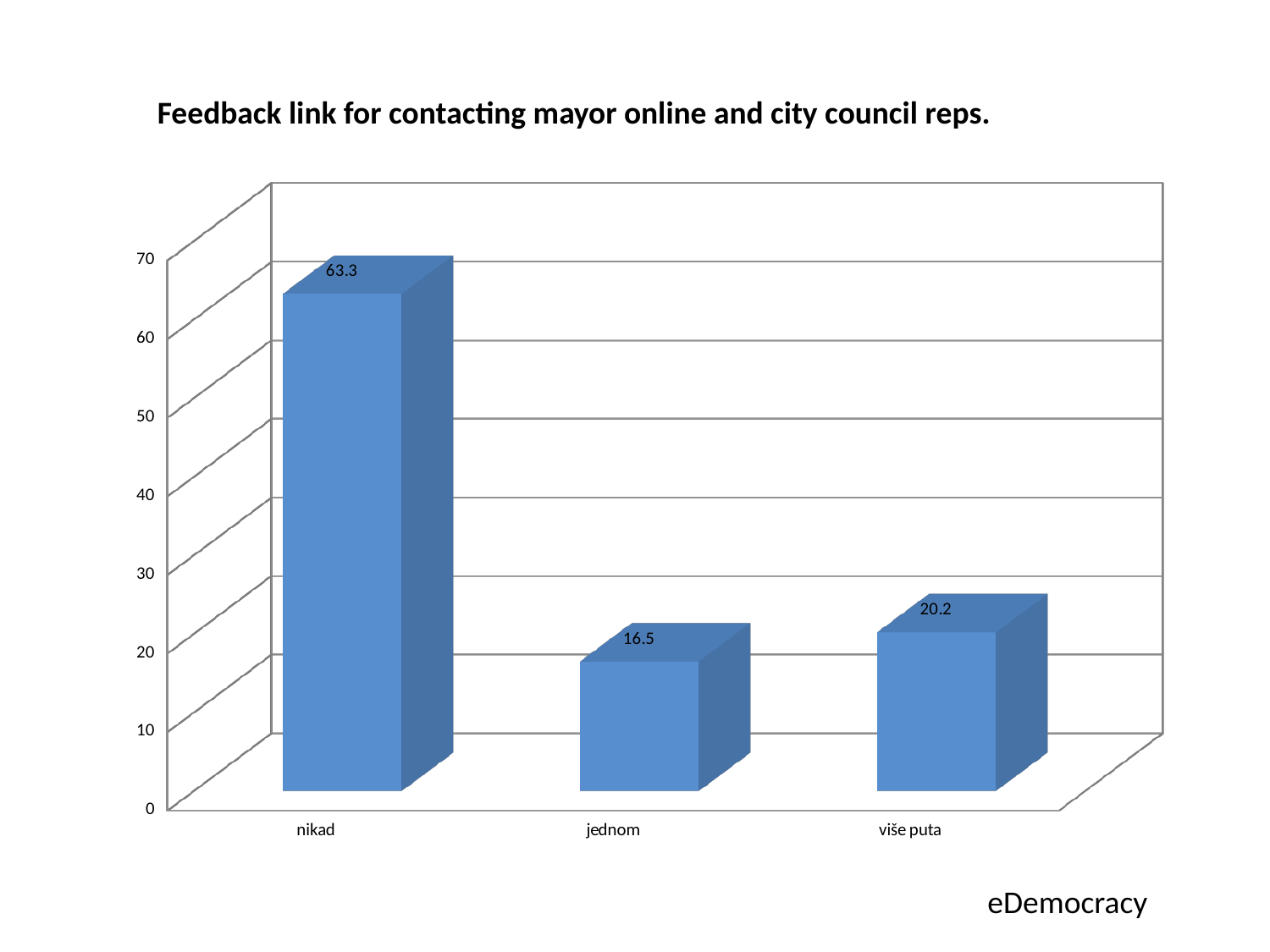
Which category has the highest value? nikad Which is larger, the value for jednom or the value for više puta? više puta What kind of chart is shown on the slide? bar chart What is the value for jednom? 16.5 What is the title of the chart? Feedback link for contacting mayor online and city council reps. What is the value for više puta? 20.2 What is the difference between the values for nikad and više puta? 43.1 What is the difference between the values for više puta and jednom? 3.7 What is the value for nikad? 63.3 Is the value for nikad greater or less than 60? greater How many categories are shown on the x axis? 3 Which category has the lowest value? jednom